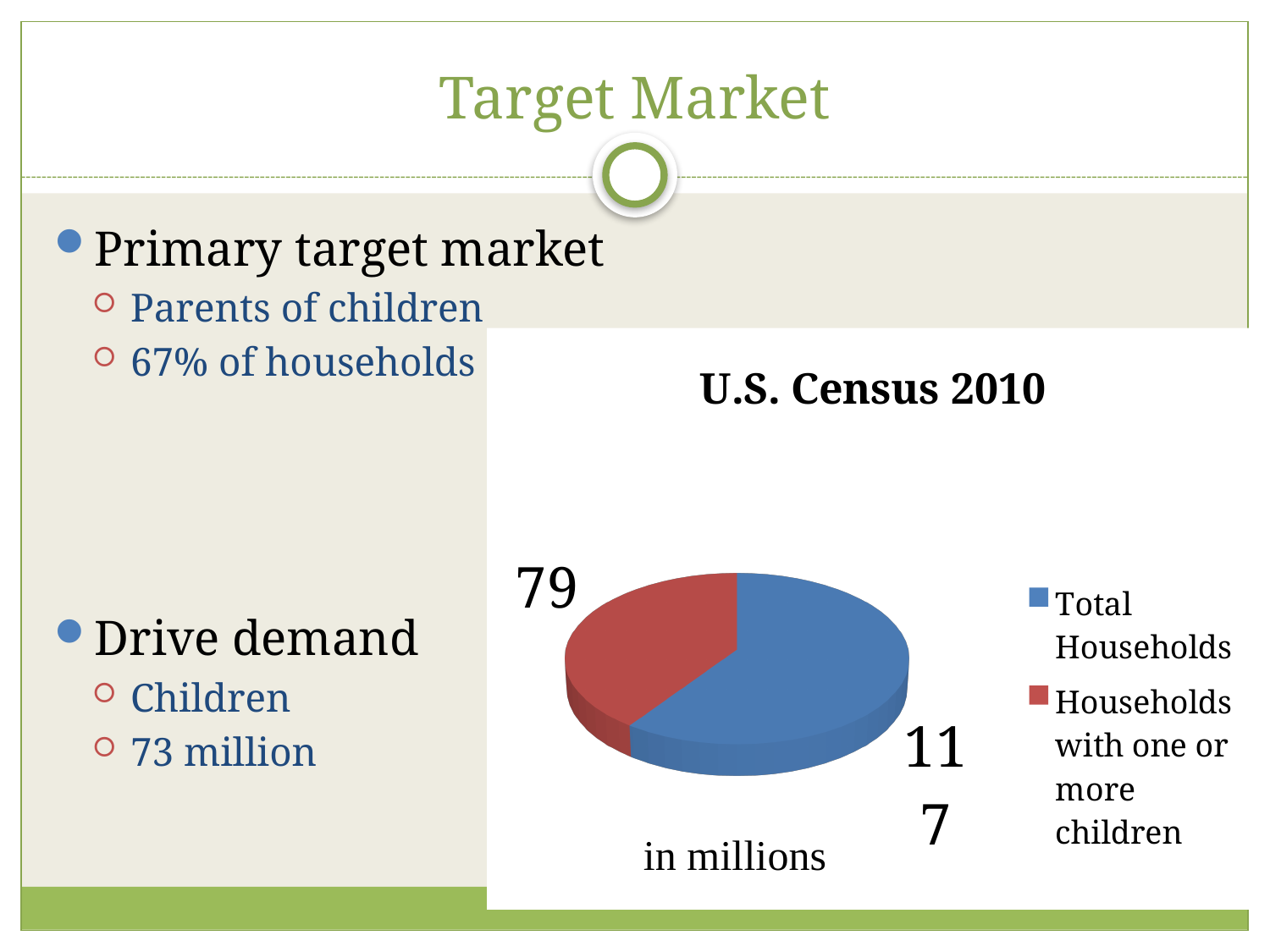
What is the title of the chart? U.S. Census 2010 What type of chart is shown on the slide? pie chart Which category has the larger slice of the pie? Total Households Is the value for Total Households larger or smaller than the value for Households with one or more children? larger Which category has the smaller slice of the pie? Households with one or more children How many slices does the pie chart have? 2 What is the difference between the value for Total Households and the value for Households with one or more children? 38 In what units are the values in the chart expressed? in millions How many entries does the legend list? 2 What value is shown for Total Households? 117 What value is shown for Households with one or more children? 79